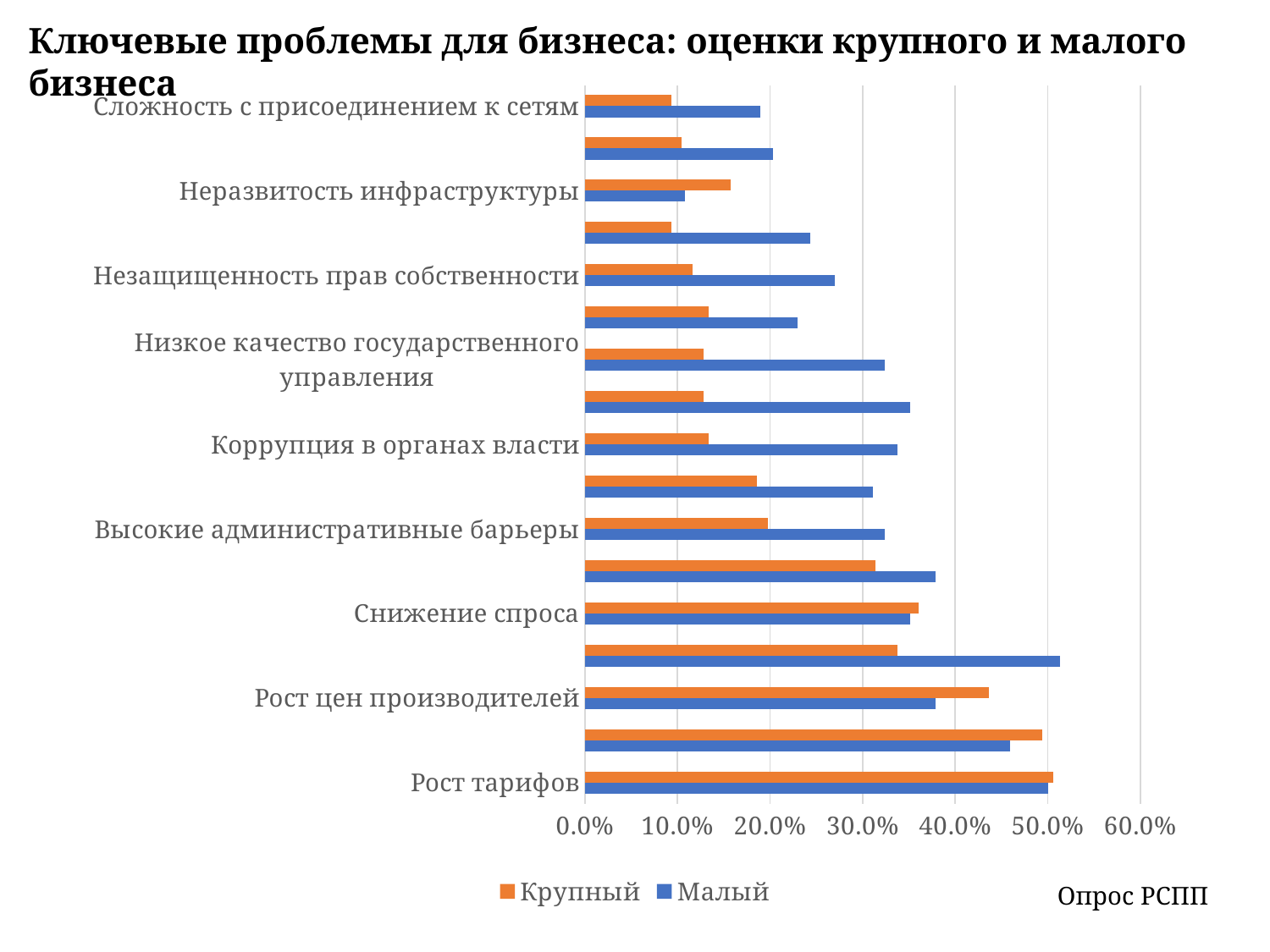
Is the Малый value for Незащищенность прав собственности greater or less than 30.0%? less What are the two series named in the legend? Крупный and Малый How many series does the legend list? 2 For Неразвитость инфраструктуры, which series has the larger value, Крупный or Малый? Крупный Is the Крупный value for Снижение спроса greater or less than 30.0%? greater Is the Крупный value for Рост цен производителей greater or less than 40.0%? greater Which colour represents the series Малый? Blue For Рост цен производителей, which series has the larger value, Крупный or Малый? Крупный For Коррупция в органах власти, which series has the larger value, Крупный or Малый? Малый What kind of chart is shown on the slide? Bar chart